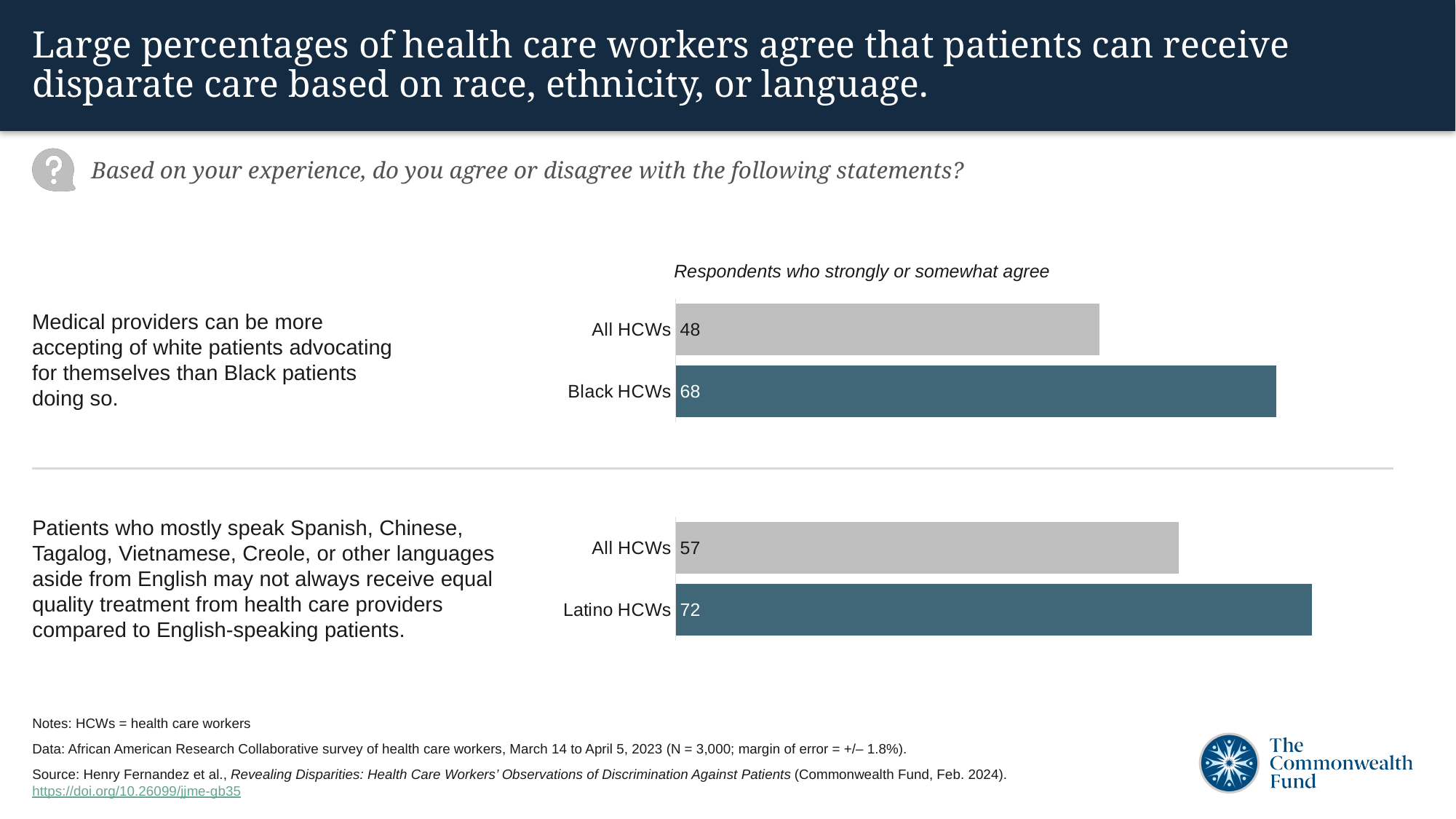
In the bottom chart, what is the difference between the values for Latino HCWs and All HCWs? 15 In the bottom chart, what colour is the bar for Latino HCWs? Dark teal In the top chart (about white patients advocating for themselves), what is the value for Black HCWs? 68 In the top chart, which group has the higher value, All HCWs or Black HCWs? Black HCWs What type of chart is used on this slide? Bar chart What does the italic heading above the charts say the bars represent? Respondents who strongly or somewhat agree In the top chart, what is the difference between the values for Black HCWs and All HCWs? 20 In the bottom chart (about patients who mostly speak languages other than English), what is the value for All HCWs? 57 In the top chart (about white patients advocating for themselves), what is the value for All HCWs? 48 In the bottom chart, which group has the lowest value? All HCWs In the bottom chart (about patients who mostly speak languages other than English), what is the value for Latino HCWs? 72 How many bars are shown in the bottom chart? 2